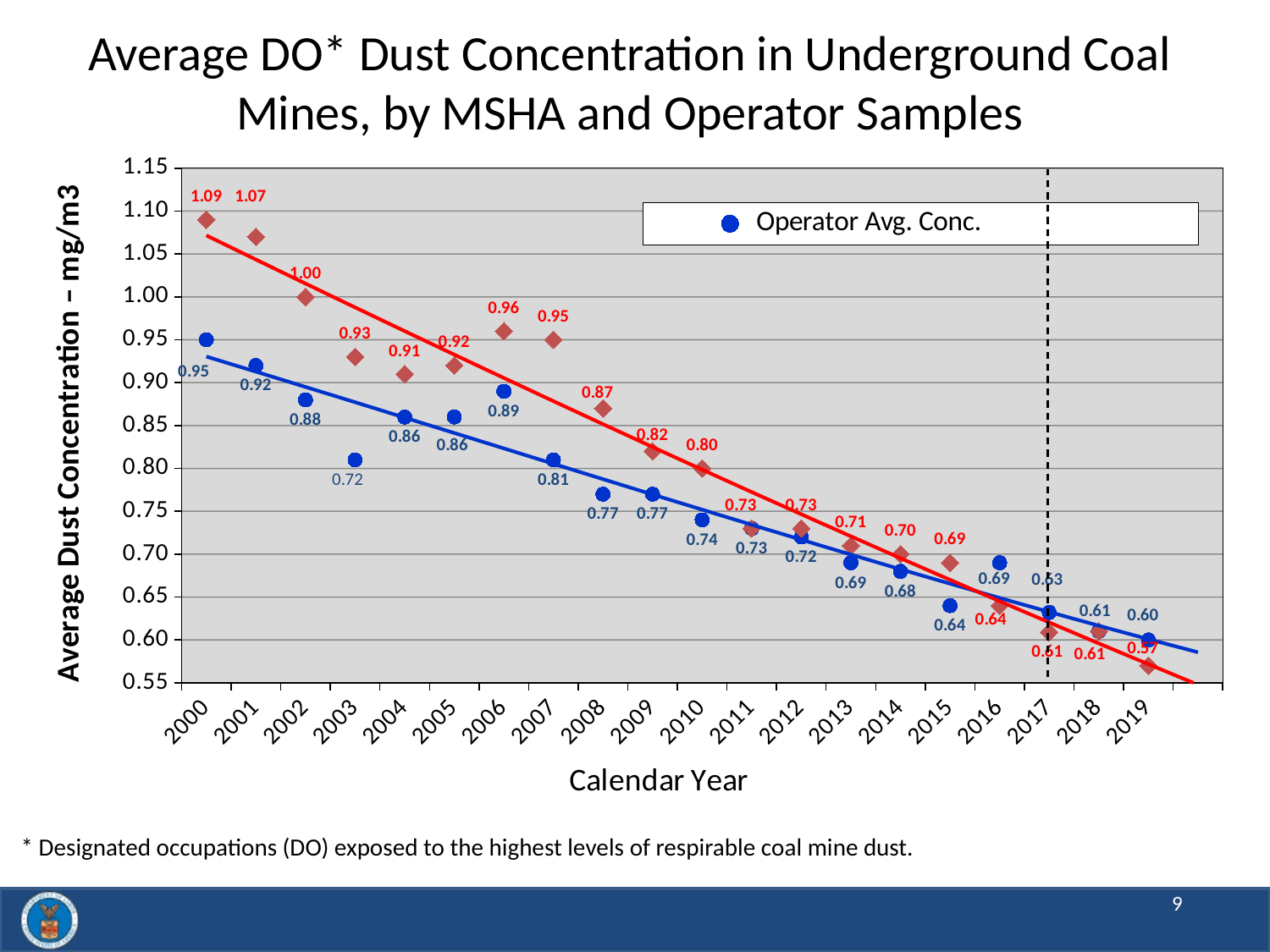
What is the Operator Avg. Conc. value for 2019? 0.60 In which year is the red diamond series at its highest value? 2000 In 2010, which is larger: the red diamond series value or the Operator Avg. Conc. value? The red diamond series (0.80) In which year is the Operator Avg. Conc. series at its lowest value? 2019 What is the value of the red diamond series for 2000? 1.09 What is the value of the red diamond series for 2019? 0.57 What kind of chart is shown on the slide? Scatter chart Do the dust concentration values generally rise or fall from 2000 to 2019? Fall What is the value of the red diamond series for 2008? 0.87 By how much did the red diamond series fall from 2000 to 2019? 0.52 What is the Operator Avg. Conc. value for 2000? 0.95 What series name is shown in the chart legend? Operator Avg. Conc.